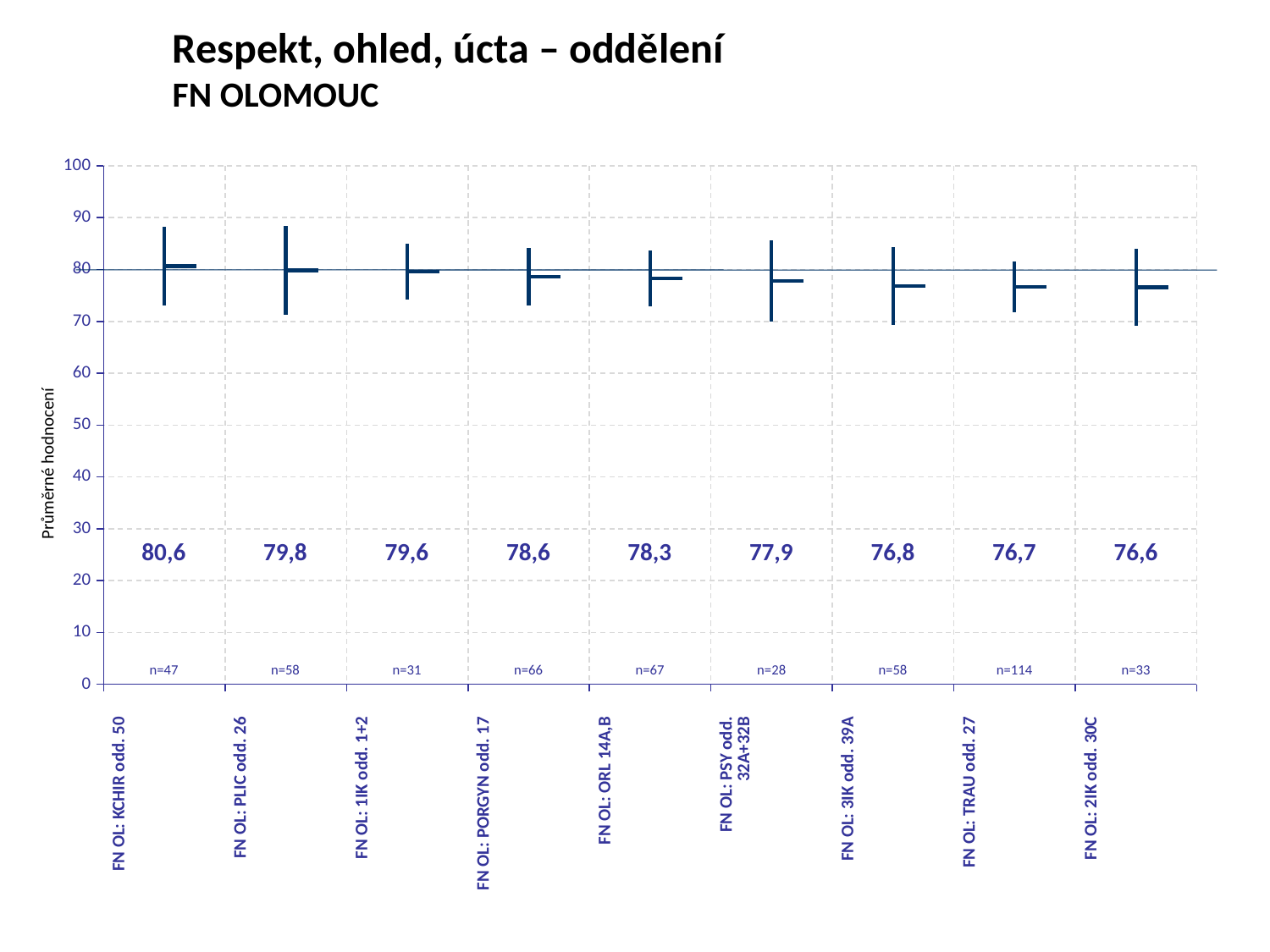
What is the label of the vertical axis? Průměrné hodnocení What is the average rating for FN OL: KCHIR odd. 50? 80,6 Which has a higher average rating, FN OL: PORGYN odd. 17 or FN OL: 3IK odd. 39A? FN OL: PORGYN odd. 17 What is the average rating for FN OL: TRAU odd. 27? 76,7 What is the sample size (n) for FN OL: TRAU odd. 27? n=114 Which department has the lowest average rating? FN OL: 2IK odd. 30C What is the sample size (n) for FN OL: PSY odd. 32A+32B? n=28 Which department has the highest average rating? FN OL: KCHIR odd. 50 What is the difference between the average ratings of FN OL: KCHIR odd. 50 and FN OL: 2IK odd. 30C? 4,0 How many departments are shown on the chart? 9 What is the average rating for FN OL: PSY odd. 32A+32B? 77,9 Do the average ratings rise or fall from left to right across the departments? fall